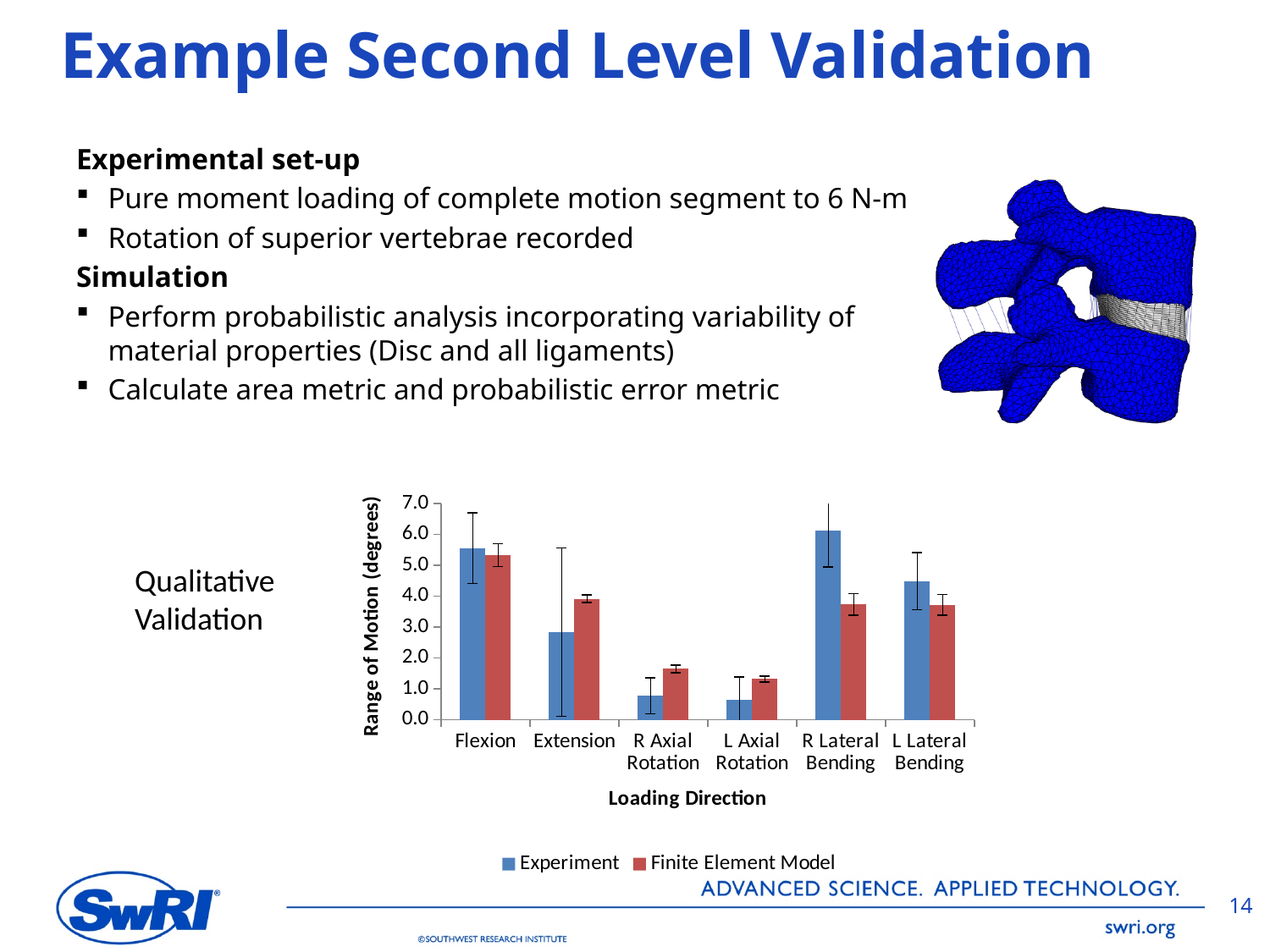
Is the Experiment value for R Axial Rotation greater or less than 1.0? less For Extension, which is larger: the Experiment value or the Finite Element Model value? Finite Element Model Which series is shown in red in the chart? Finite Element Model What is the title of the chart's y axis? Range of Motion (degrees) For R Lateral Bending, which is larger: the Experiment value or the Finite Element Model value? Experiment Is the Finite Element Model value for Extension greater or less than 3.0? greater How many series does the chart's legend list? 2 Which loading direction has the highest Experiment value? R Lateral Bending Which loading direction has the lowest Finite Element Model value? L Axial Rotation Is the Experiment value for Flexion greater or less than 5.0? greater What kind of chart is shown on the slide? Bar chart How many loading directions (categories) are shown on the x axis of the chart? 6